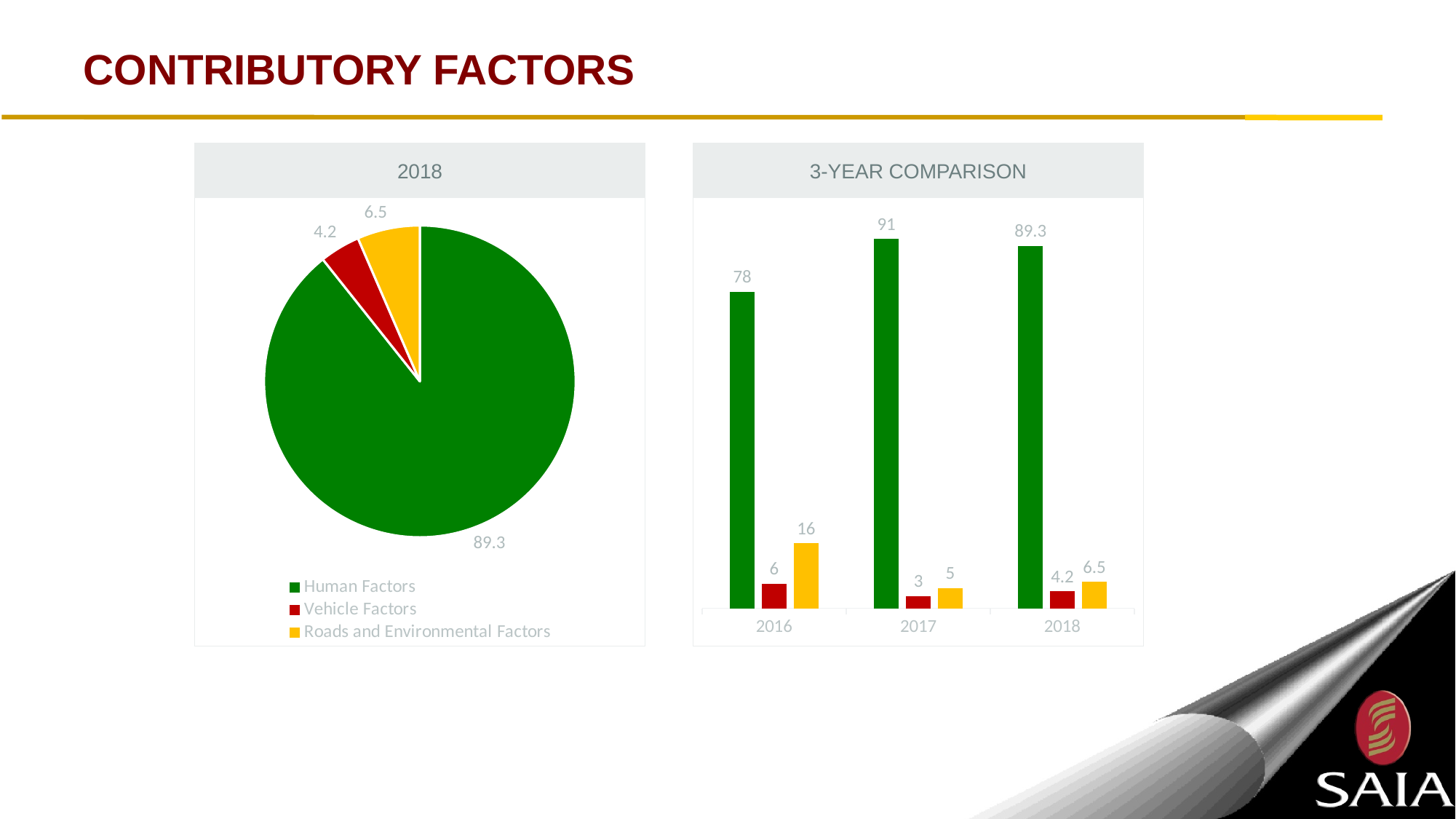
In the 2018 pie chart, what is the value for Vehicle Factors? 4.2 In the 2018 pie chart, how many categories does the legend list? 3 In the 3-YEAR COMPARISON chart, how many years are shown on the x axis? 3 What kind of chart is the 3-YEAR COMPARISON chart? Bar chart In the 3-YEAR COMPARISON chart, what is the value of the green (Human Factors) bar for 2016? 78 In the 2018 pie chart, what is the difference between the Roads and Environmental Factors value and the Vehicle Factors value? 2.3 In the 2018 pie chart, what is the value for Human Factors? 89.3 In the 3-YEAR COMPARISON chart, what is the value of the yellow (Roads and Environmental Factors) bar for 2017? 5 In the 3-YEAR COMPARISON chart, which year has the highest green (Human Factors) bar? 2017 In the 3-YEAR COMPARISON chart, what is the difference between the green bar values for 2017 and 2016? 13 In the 3-YEAR COMPARISON chart, is the yellow bar for 2016 larger or smaller than the yellow bar for 2018? Larger In the 2018 pie chart, which category has the smallest slice? Vehicle Factors